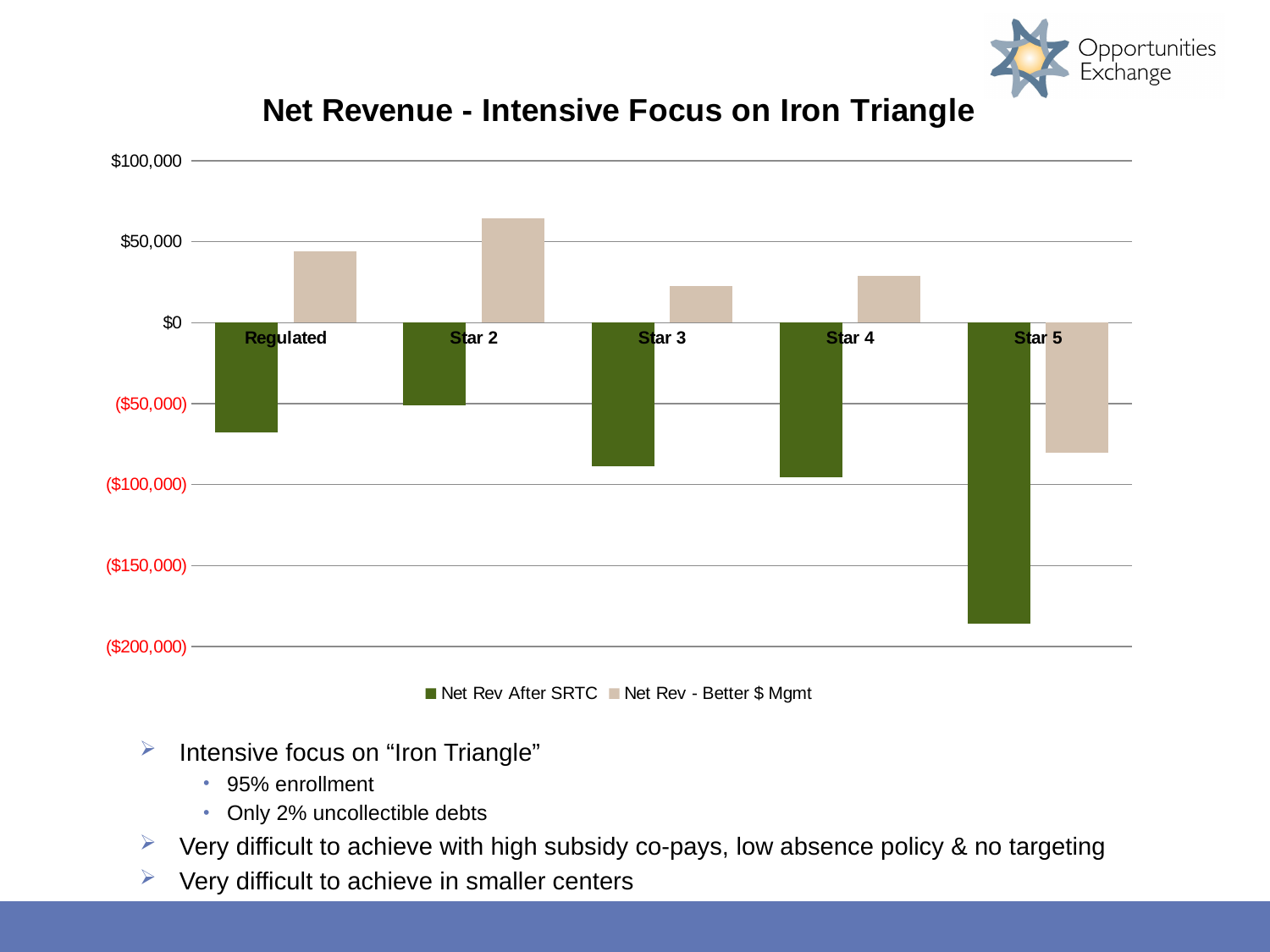
What is the title of the chart? Net Revenue - Intensive Focus on Iron Triangle What kind of chart is shown on the slide? Bar chart Which is larger, the Net Rev - Better $ Mgmt value for Regulated or for Star 3? Regulated Is the Net Rev - Better $ Mgmt value for Star 5 greater or less than ($50,000)? less Which category has the lowest value for Net Rev - Better $ Mgmt? Star 5 How many categories are shown on the x axis of the chart? 5 Is the Net Rev - Better $ Mgmt value for Star 2 greater or less than $50,000? greater How many series does the chart's legend list? 2 Is the Net Rev - Better $ Mgmt value for Regulated greater or less than $50,000? less Which category has the highest value for Net Rev - Better $ Mgmt? Star 2 Which category has the lowest value for Net Rev After SRTC? Star 5